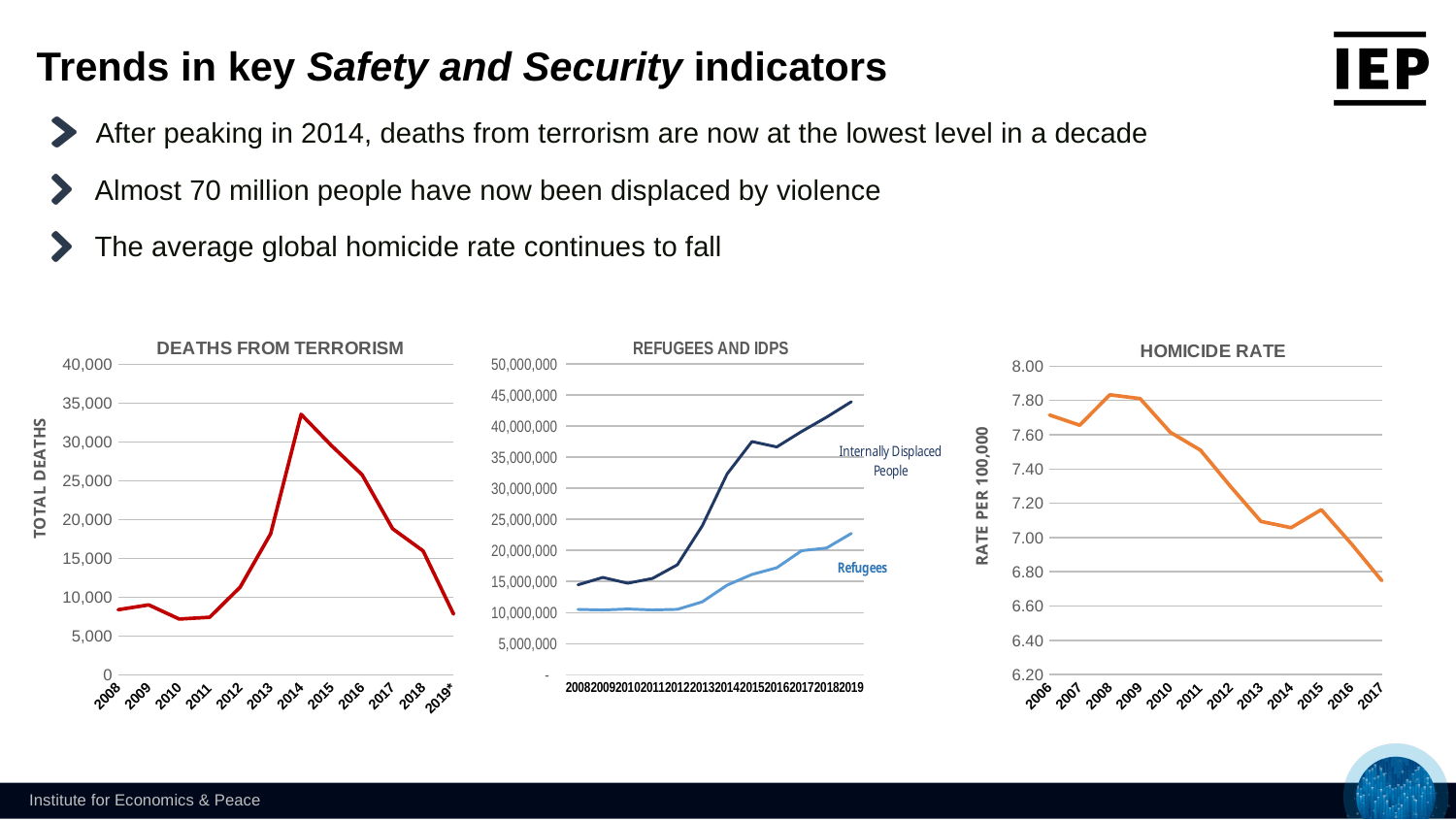
What kind of chart is the 'Deaths from Terrorism' chart? line chart In the 'Homicide Rate' chart, which year has the lowest homicide rate? 2017 How many years are plotted on the x axis of the 'Deaths from Terrorism' chart? 12 In the 'Deaths from Terrorism' chart, is the value for 2014 greater or less than 30,000? greater In the 'Refugees and IDPs' chart, is the value for Internally Displaced People in 2019 greater or less than 40,000,000? greater In the 'Refugees and IDPs' chart, which series is higher in 2019, Internally Displaced People or Refugees? Internally Displaced People In the 'Deaths from Terrorism' chart, is the value for 2019* greater or less than 10,000? less What is the y-axis title of the 'Homicide Rate' chart? RATE PER 100,000 In the 'Deaths from Terrorism' chart, which year has the highest number of deaths? 2014 How many series are shown in the 'Refugees and IDPs' chart? 2